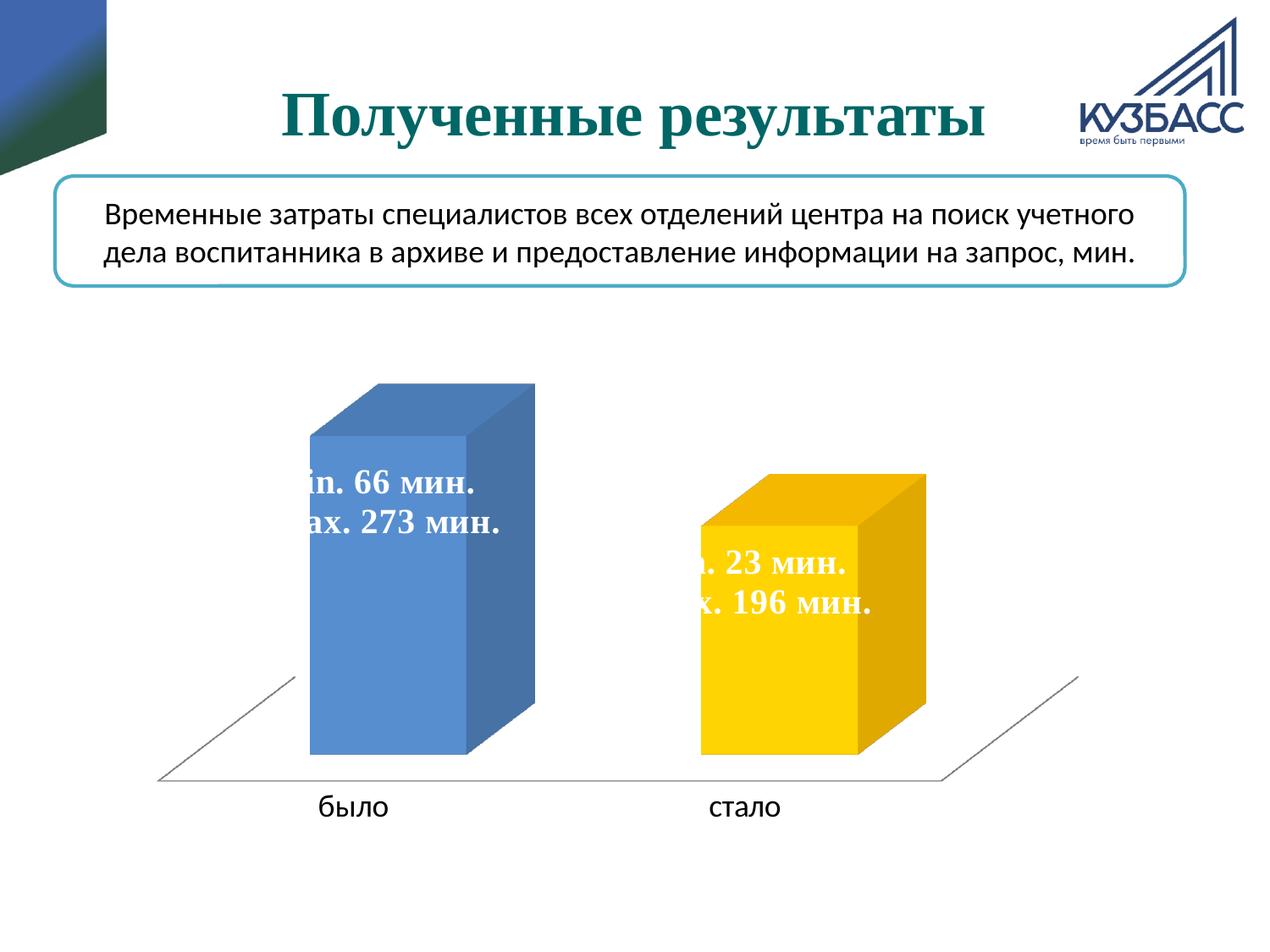
What maximum time is printed on the "было" bar? 273 мин. What kind of chart is shown on the slide? bar chart What minimum time is printed on the "стало" bar? 23 мин. What colour is the bar for "стало"? yellow How many categories are shown on the x axis of the chart? 2 What minimum time is printed on the "было" bar? 66 мин. Do the bar values rise or fall from "было" to "стало"? fall By how many minutes did the maximum time fall from "было" to "стало"? 77 мин. Which category has the taller bar, "было" or "стало"? было Which category has the lowest bar in the chart? стало What maximum time is printed on the "стало" bar? 196 мин. Which category has the highest bar in the chart? было